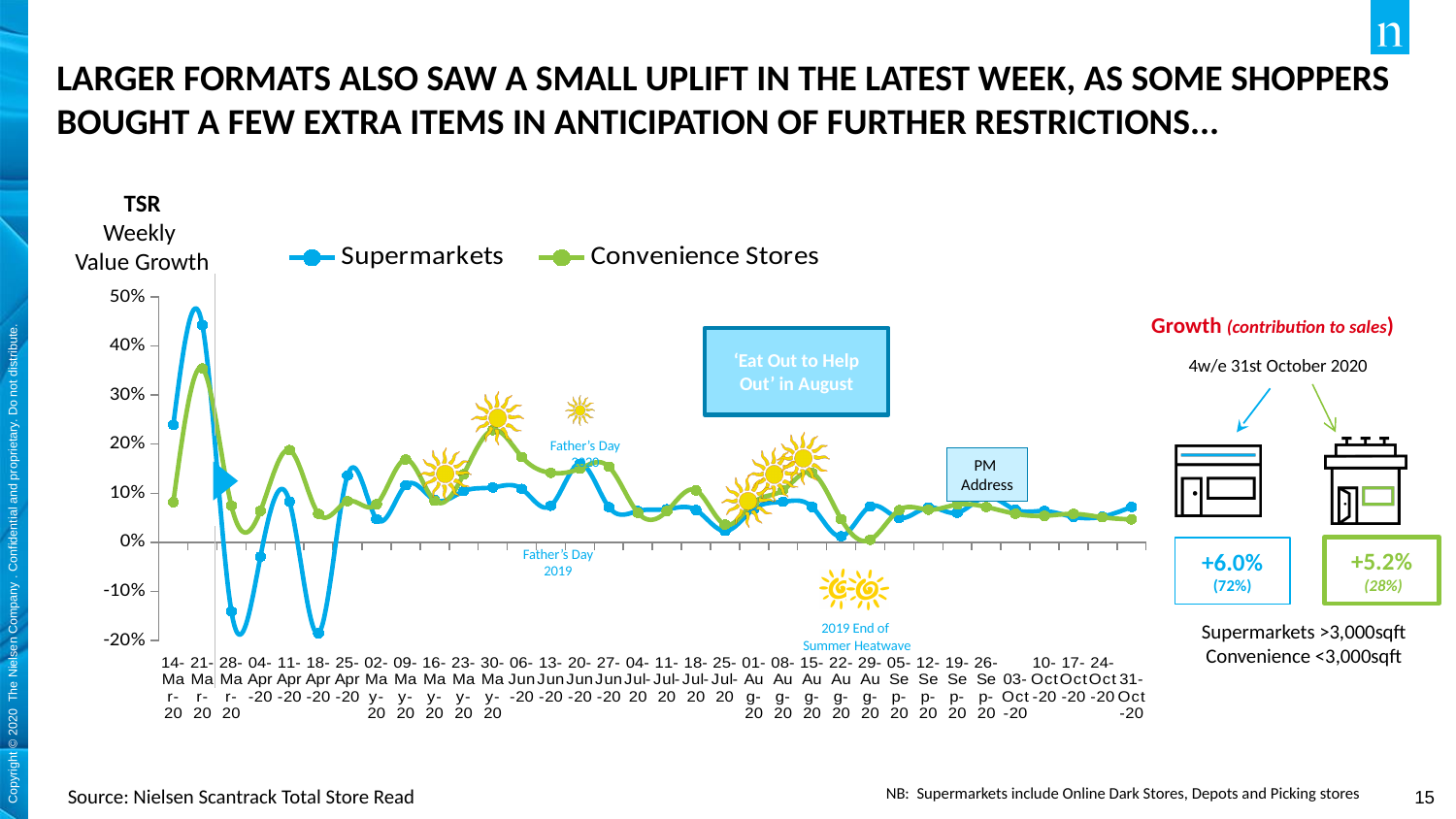
What is the highest value shown on the chart's vertical axis? 50% What kind of chart is shown on the slide? Line chart Is the peak value for Supermarkets around 21-Mar-20 greater or less than 40%? greater What is the title of the chart? TSR Weekly Value Growth Which series reaches the highest peak on the chart? Supermarkets Which series has the lowest point on the chart? Supermarkets What are the two series named in the chart legend? Supermarkets and Convenience Stores Is the peak value for Convenience Stores around 21-Mar-20 greater or less than 30%? greater How many series does the chart legend list? 2 At 21-Mar-20, which series has the higher value, Supermarkets or Convenience Stores? Supermarkets Is the value for Supermarkets at 28-Mar-20 greater or less than -10%? less